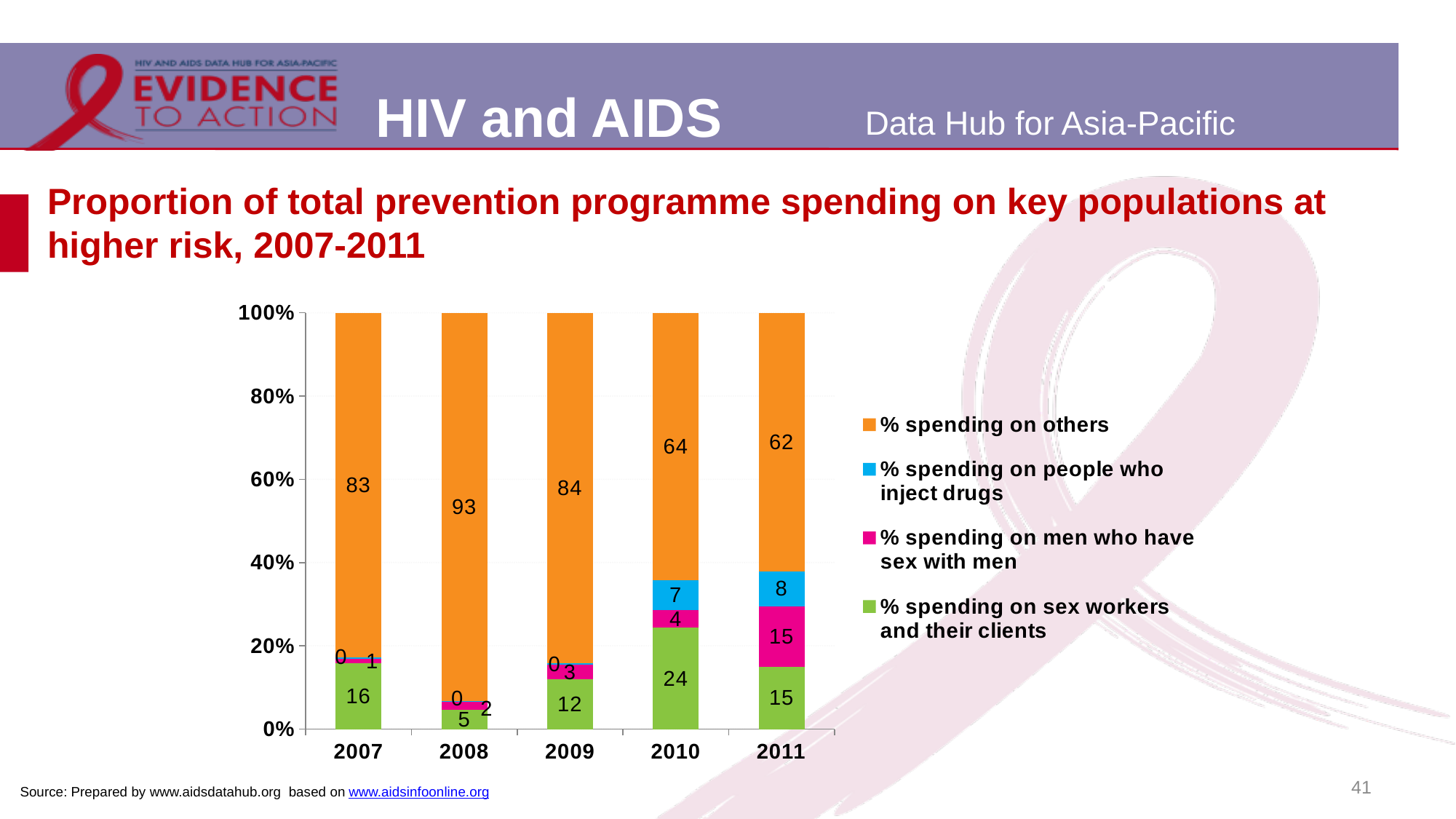
What percentage of spending went to sex workers and their clients in 2010? 24 What percentage of spending went to men who have sex with men in 2009? 3 In which year was the share of spending on others the highest? 2008 Which is larger: the share of spending on men who have sex with men in 2011 or in 2010? 2011 What percentage of spending went to people who inject drugs in 2011? 8 In which year was the share of spending on sex workers and their clients the lowest? 2008 Which colour represents % spending on people who inject drugs? Blue What kind of chart is shown on the slide? Stacked bar chart What is the difference between the share of spending on others in 2007 and in 2011? 21 What percentage of spending went to others in 2008? 93 How many series does the legend list? 4 How many years are shown on the x axis? 5